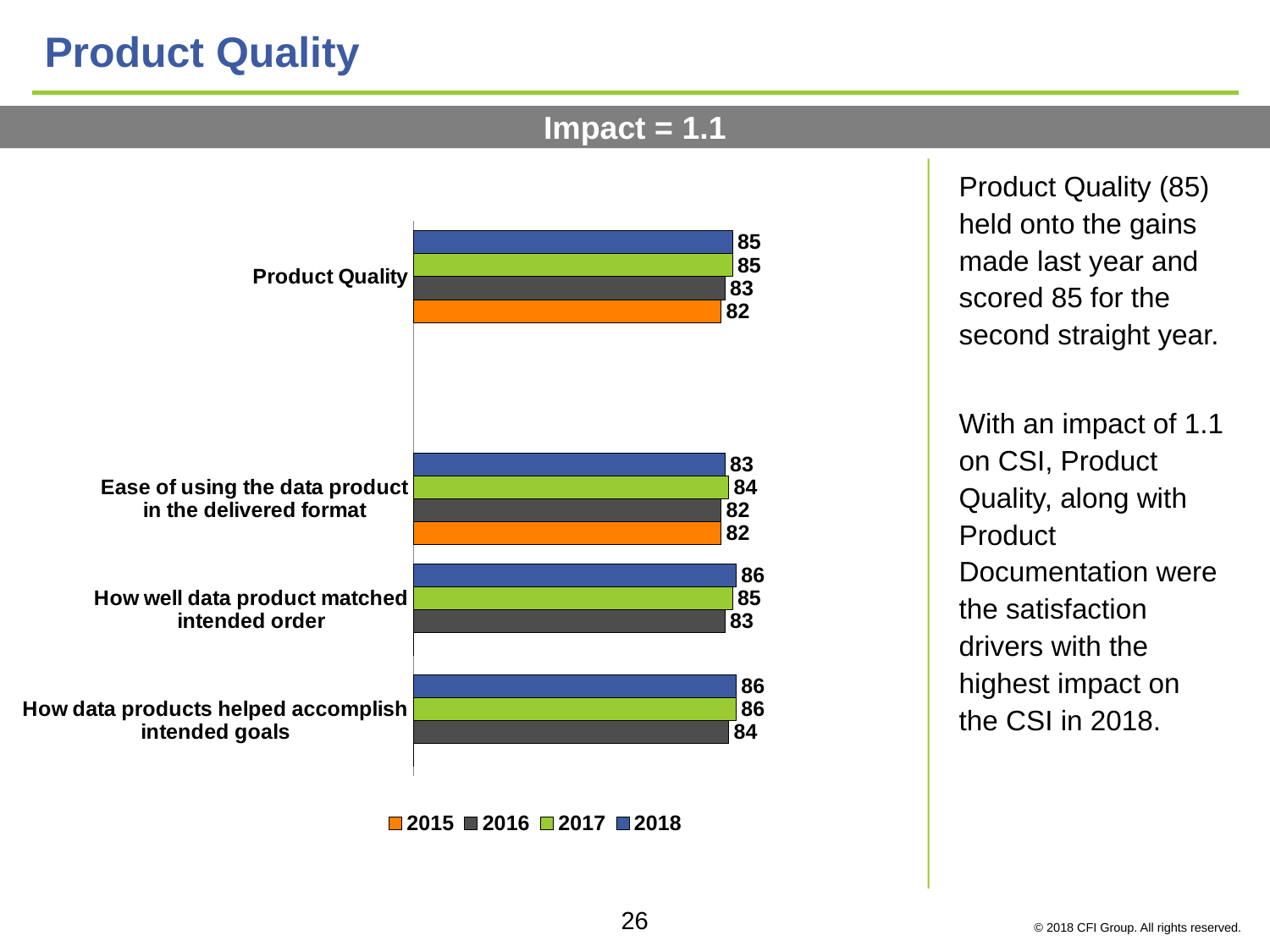
Which is larger for Ease of using the data product in the delivered format: the 2017 value or the 2018 value? 2017 What colour represents the 2015 series in the legend? Orange How many categories are shown on the chart? 4 What is the 2016 value for How well data product matched intended order? 83 Which category has the lowest 2016 value? Ease of using the data product in the delivered format What is the difference between the 2018 and 2015 values for Product Quality? 3 What is the 2018 value for Product Quality? 85 What is the 2017 value for How data products helped accomplish intended goals? 86 What kind of chart is shown on the slide? Bar chart What is the 2015 value for Ease of using the data product in the delivered format? 82 Which category has the lowest 2018 value? Ease of using the data product in the delivered format How many series does the legend list? 4